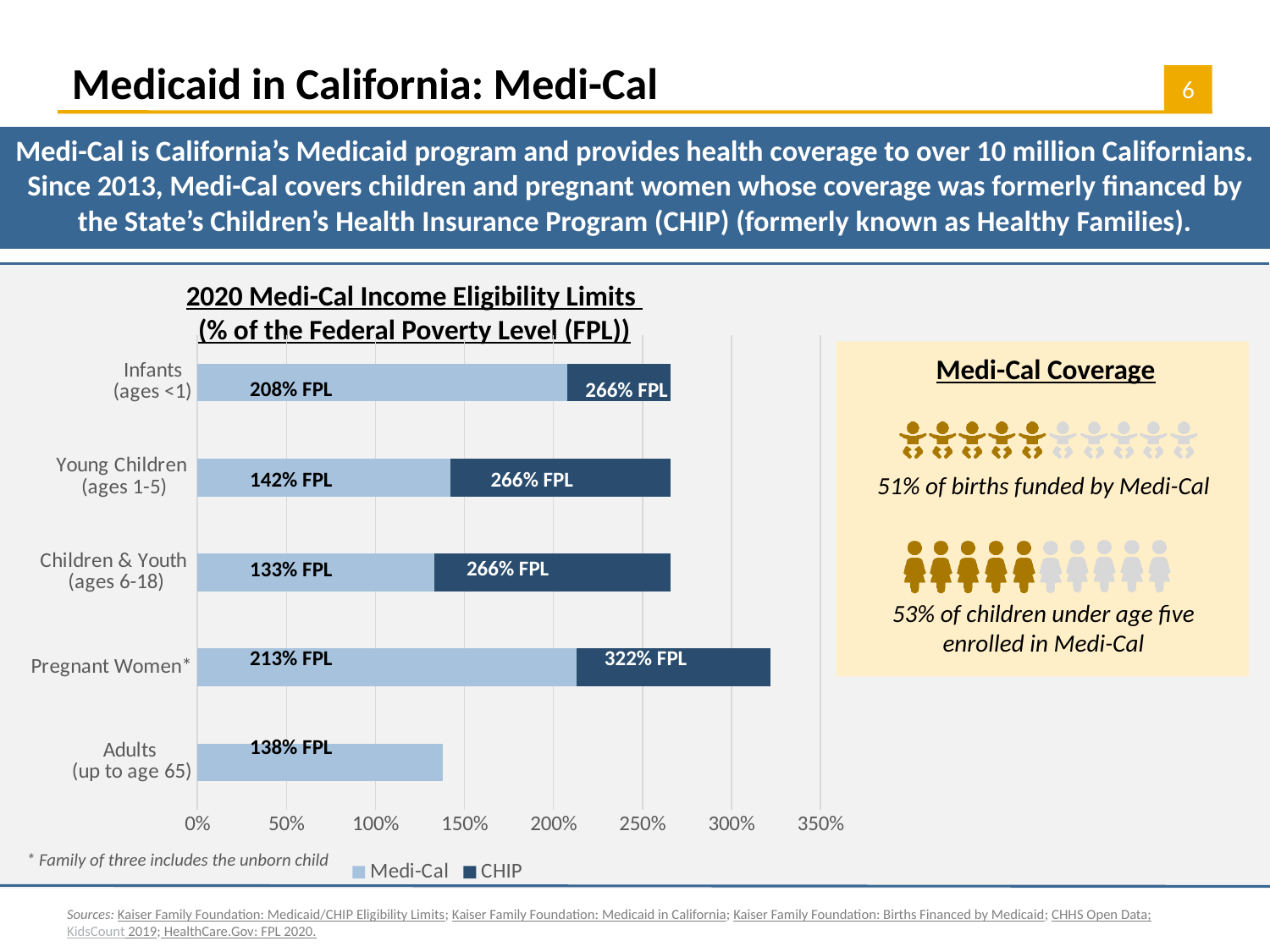
Which category has the highest Medi-Cal income eligibility limit? Pregnant Women* What is the title of the chart? 2020 Medi-Cal Income Eligibility Limits (% of the Federal Poverty Level (FPL)) What type of chart is shown on the slide? Stacked horizontal bar chart What is the Medi-Cal income eligibility limit for Adults (up to age 65)? 138% FPL What is the upper eligibility limit (end of the CHIP segment) for Pregnant Women*? 322% FPL How many categories are shown on the chart? 5 Which is larger, the Medi-Cal limit for Young Children (ages 1-5) or for Adults (up to age 65)? Young Children (ages 1-5) What is the Medi-Cal income eligibility limit for Infants (ages <1)? 208% FPL Is the total bar for Infants (ages <1) greater or less than 250%? greater Which category has the lowest Medi-Cal income eligibility limit? Children & Youth (ages 6-18) How many series does the chart legend list? 2 What is the Medi-Cal income eligibility limit for Children & Youth (ages 6-18)? 133% FPL